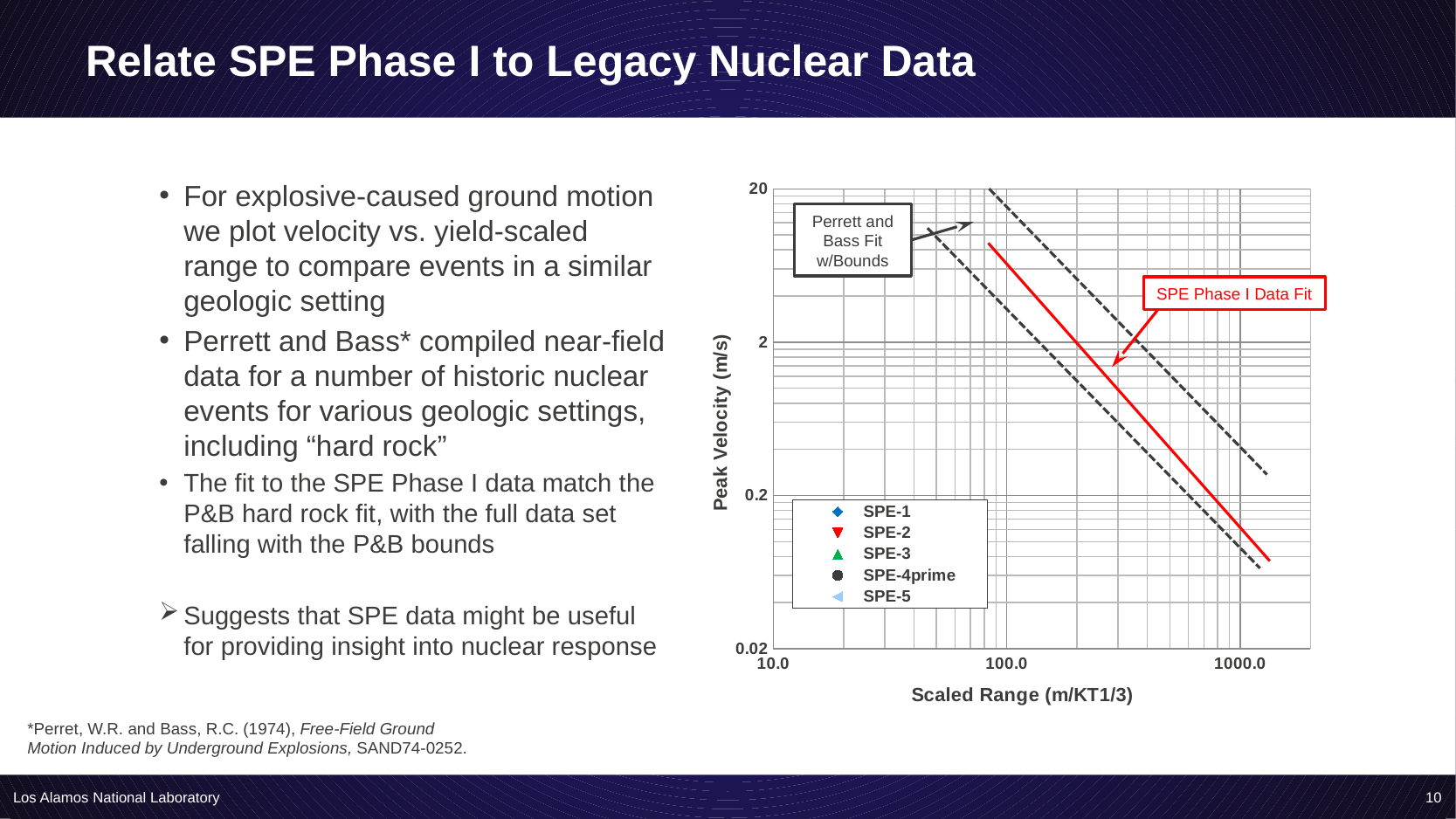
At a scaled range of 1000.0, is the value of the SPE Phase I Data Fit line greater or less than 0.2? less At a scaled range of 100.0, is the value of the SPE Phase I Data Fit line greater or less than 2? greater At a scaled range of 100.0, is the value of the upper Perrett and Bass bound line greater or less than 2? greater What is the label of the chart's y axis? Peak Velocity (m/s) What is the highest tick value shown on the chart's y axis? 20 How many series does the chart's legend list? 5 What is the lowest tick value shown on the chart's x axis? 10.0 What colour is the SPE Phase I Data Fit line on the chart? red What kind of chart is shown on the slide? line chart Does peak velocity rise or fall as scaled range increases along the x axis? fall